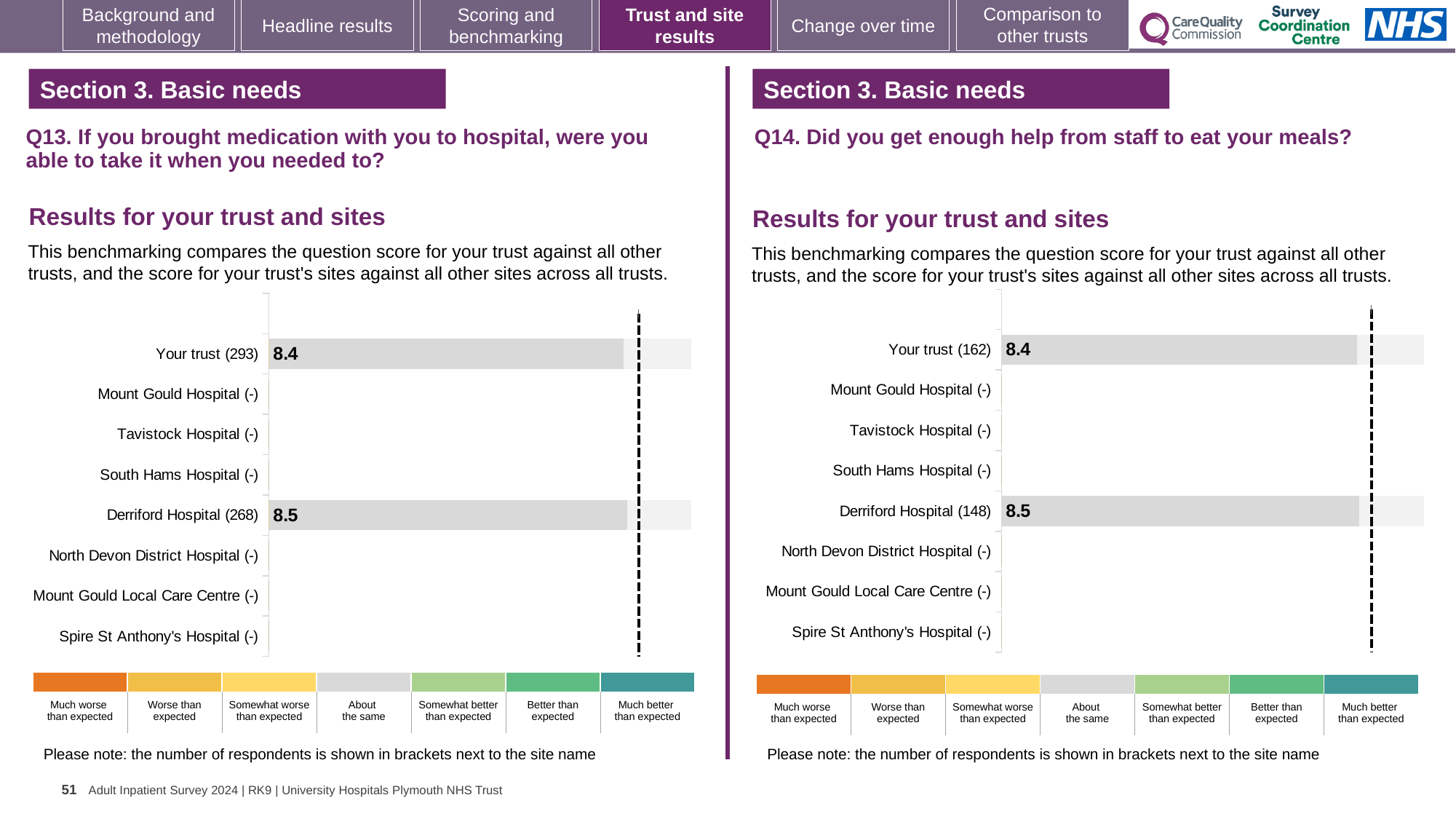
In the Q14 chart on the right, which has the higher score, Your trust or Derriford Hospital? Derriford Hospital In the Q14 chart on the right, what is the score for Derriford Hospital (148)? 8.5 What kind of chart is used in the Q13 chart on the left? Bar chart In the Q13 chart on the left, how many respondents are shown in brackets for Derriford Hospital? 268 In the Q13 chart on the left, what is the difference between the Derriford Hospital score and the Your trust score? 0.1 In the Q13 chart on the left, what is the score for Derriford Hospital (268)? 8.5 In the Q13 chart on the left, which category has the highest plotted score? Derriford Hospital (268) In the Q14 chart on the right, what is the score for Your trust (162)? 8.4 In the Q14 chart on the right, how many respondents are shown in brackets for Your trust? 162 In the Q13 chart on the left, how many site/trust categories are listed on the vertical axis? 8 In the Q13 chart on the left, what is the score for Your trust (293)? 8.4 In the Q14 chart on the right, how many categories have a plotted bar with a score? 2